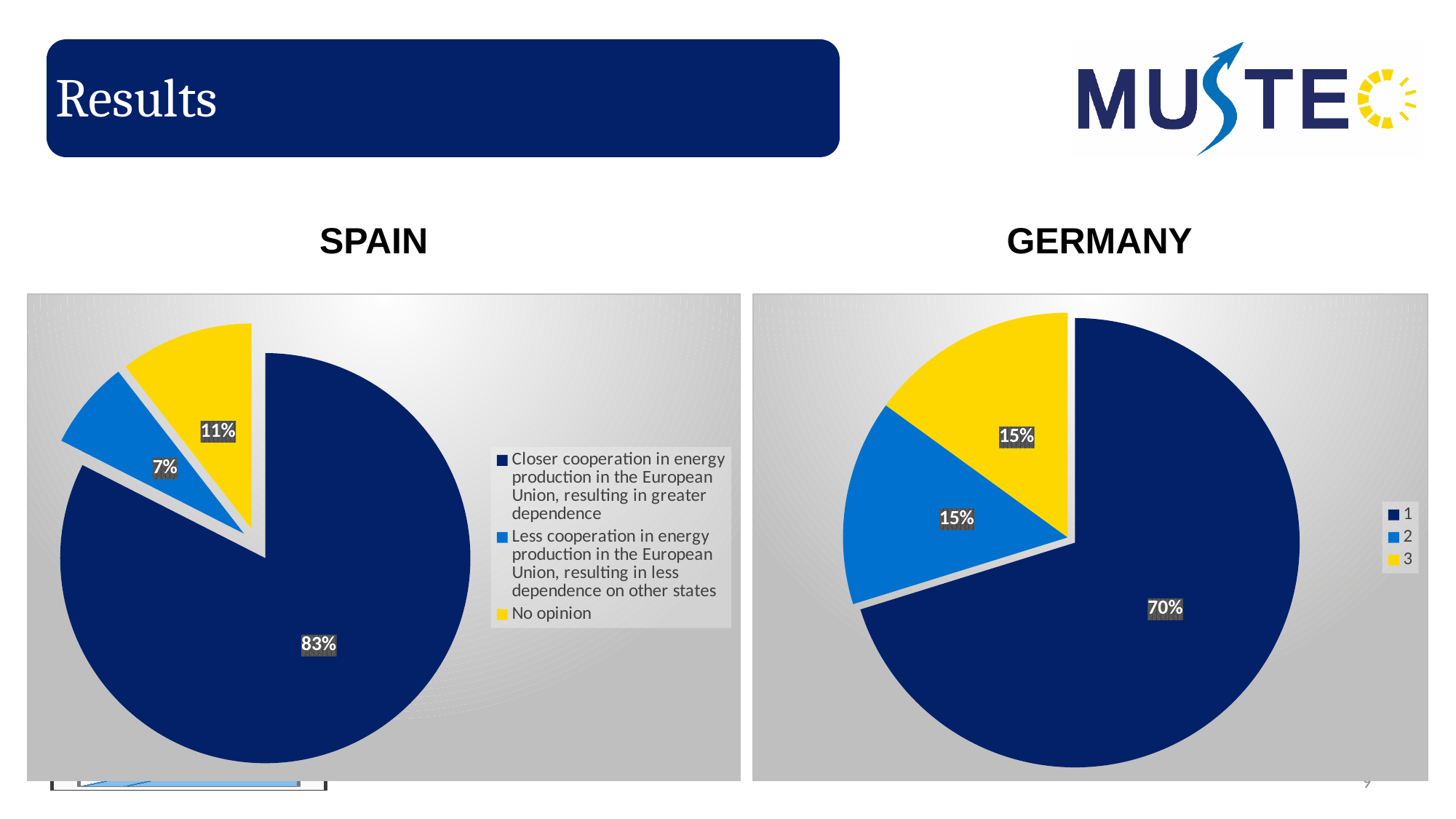
In the SPAIN chart, which category has the smallest share? Less cooperation in energy production in the European Union, resulting in less dependence on other states In the SPAIN chart, what share of respondents chose 'Closer cooperation in energy production in the European Union, resulting in greater dependence'? 83% In the SPAIN chart, what share of respondents chose 'Less cooperation in energy production in the European Union, resulting in less dependence on other states'? 7% In the SPAIN chart, what share of respondents chose 'No opinion'? 11% In the GERMANY chart, what share is shown for category 2? 15% In the SPAIN chart, what is the difference in percentage points between the 'No opinion' slice and the 'Less cooperation' slice? 4 percentage points What type of chart is used for the SPAIN results? Pie chart In the GERMANY chart, what share is shown for category 1? 70% In the GERMANY chart, which category has the largest share? 1 How many slices does the GERMANY pie chart have? 3 Which is larger: the largest slice in the SPAIN chart or the largest slice in the GERMANY chart? The largest slice in the SPAIN chart (83%) How many entries does the legend of the GERMANY chart list? 3